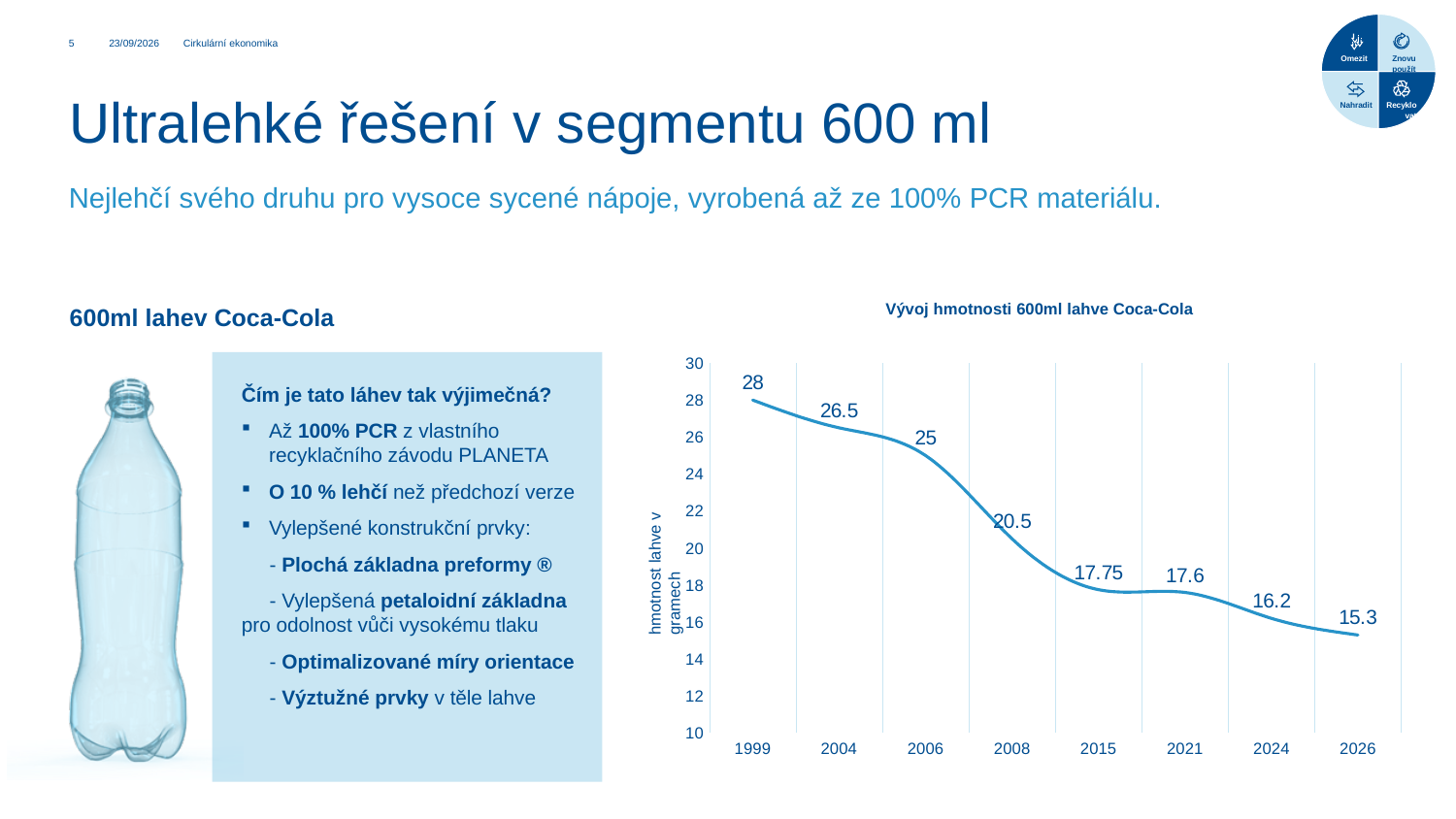
Does the bottle weight rise or fall from 1999 to 2026? Fall What is the weight of the 600ml Coca-Cola bottle in 1999? 28 What is the weight of the 600ml Coca-Cola bottle in 2026? 15.3 Which year has a higher bottle weight, 2004 or 2021? 2004 What is the weight of the 600ml Coca-Cola bottle in 2015? 17.75 What type of chart is shown on the slide? Line chart What is the weight of the 600ml Coca-Cola bottle in 2008? 20.5 How many years are plotted on the chart? 8 What is the difference in bottle weight between 2006 and 2008? 4.5 What is the difference in bottle weight between 1999 and 2026? 12.7 In which year is the bottle weight lowest? 2026 In which year is the bottle weight highest? 1999